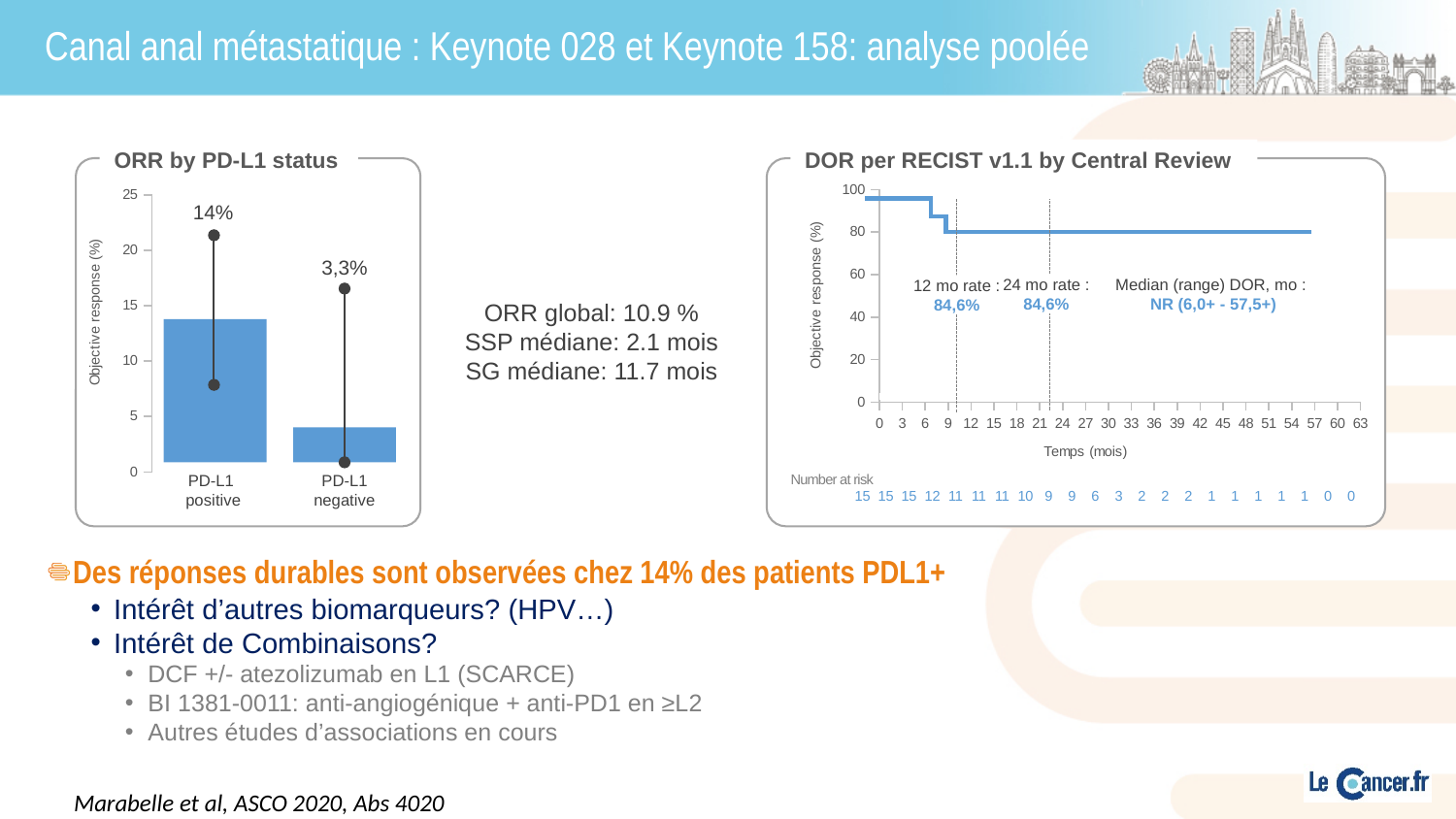
In the 'ORR by PD-L1 status' chart, is the value for PD-L1 negative greater or less than 5? less What kind of chart is 'ORR by PD-L1 status'? bar chart In the 'ORR by PD-L1 status' chart, is the value for PD-L1 positive greater or less than 10? greater In the 'ORR by PD-L1 status' chart, what is the objective response rate for PD-L1 positive patients? 14% In the 'ORR by PD-L1 status' chart, which category has the higher objective response rate? PD-L1 positive In the 'DOR per RECIST v1.1 by Central Review' chart, what is the title of the x axis? Temps (mois) How many categories are shown in the 'ORR by PD-L1 status' chart? 2 In the 'DOR per RECIST v1.1 by Central Review' chart, what is the number at risk at 0 months? 15 In the 'DOR per RECIST v1.1 by Central Review' chart, what is the 12 mo rate? 84,6% In the 'DOR per RECIST v1.1 by Central Review' chart, what is the median (range) DOR in months? NR (6,0+ - 57,5+) In the 'ORR by PD-L1 status' chart, what is the objective response rate for PD-L1 negative patients? 3,3% In the 'ORR by PD-L1 status' chart, which category has the lowest objective response rate? PD-L1 negative